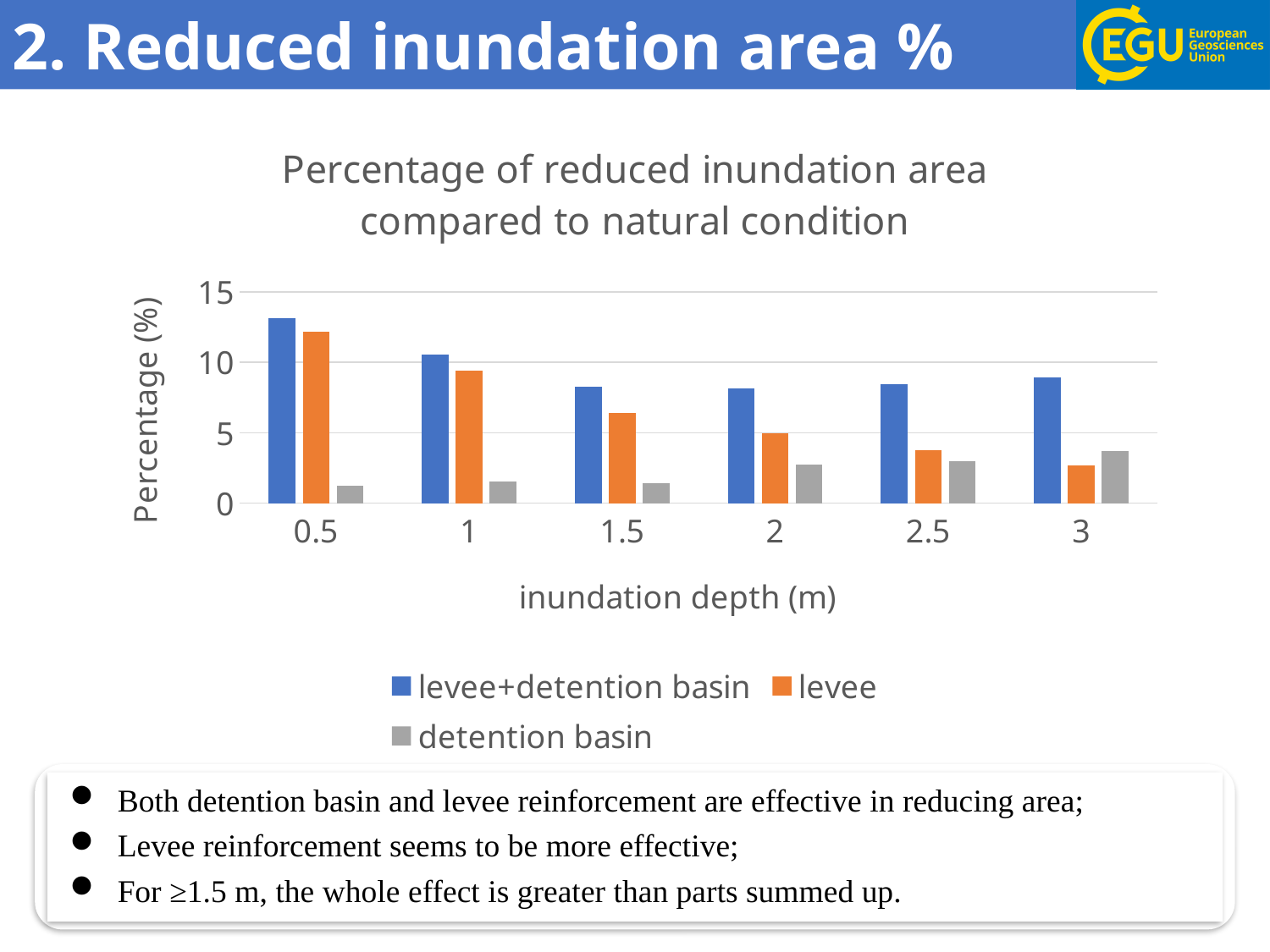
At which inundation depth is the value for the levee series lowest? 3 How many inundation depth categories are shown on the x axis? 6 Is the value for levee+detention basin at inundation depth 0.5 greater or less than 10? greater Do the values for the levee series rise or fall as inundation depth increases? fall Is the value for levee at inundation depth 3 greater or less than 5? less At which inundation depth is the value for the detention basin series highest? 3 At inundation depth 2, which is larger: the value for levee or the value for detention basin? levee Is the value for levee+detention basin at inundation depth 1.5 greater or less than 5? greater At which inundation depth is the value for the levee series highest? 0.5 How many series does the legend list? 3 What kind of chart is shown on the slide? bar chart What is the label of the y axis? Percentage (%)